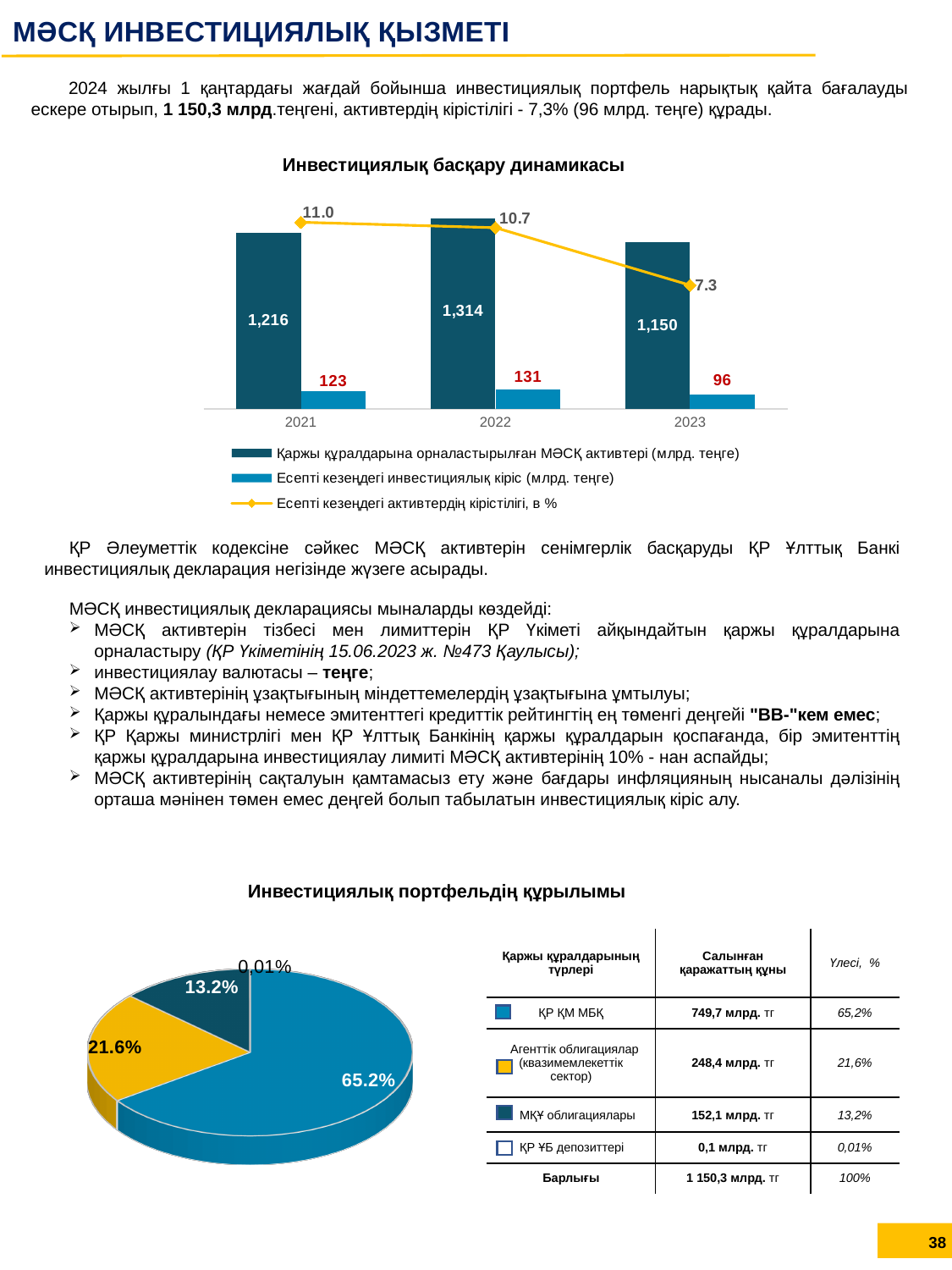
In the chart 'Инвестициялық басқару динамикасы', what is the line value (Есепті кезеңдегі активтердің кірістілігі, в %) for 2021? 11.0 How many years are shown on the x axis of the chart 'Инвестициялық басқару динамикасы'? 3 In the chart 'Инвестициялық басқару динамикасы', which year has the lowest value for Есепті кезеңдегі инвестициялық кіріс? 2023 In the chart 'Инвестициялық басқару динамикасы', what is the value of the light bar (Есепті кезеңдегі инвестициялық кіріс) for 2023? 96 How many series does the legend of the chart 'Инвестициялық басқару динамикасы' list? 3 In the pie chart 'Инвестициялық портфельдің құрылымы', what is the share of the yellow slice? 21.6% In the pie chart 'Инвестициялық портфельдің құрылымы', what share does the largest slice have? 65.2% What kind of chart is 'Инвестициялық портфельдің құрылымы'? pie chart In the chart 'Инвестициялық басқару динамикасы', what is the difference between the Есепті кезеңдегі инвестициялық кіріс values for 2022 and 2021? 8 In the chart 'Инвестициялық басқару динамикасы', which year has the highest value for Қаржы құралдарына орналастырылған МӘСҚ активтері? 2022 In the chart 'Инвестициялық басқару динамикасы', what is the value of the dark bar (Қаржы құралдарына орналастырылған МӘСҚ активтері) for 2022? 1,314 In the chart 'Инвестициялық басқару динамикасы', does the line for Есепті кезеңдегі активтердің кірістілігі rise or fall from 2021 to 2023? fall